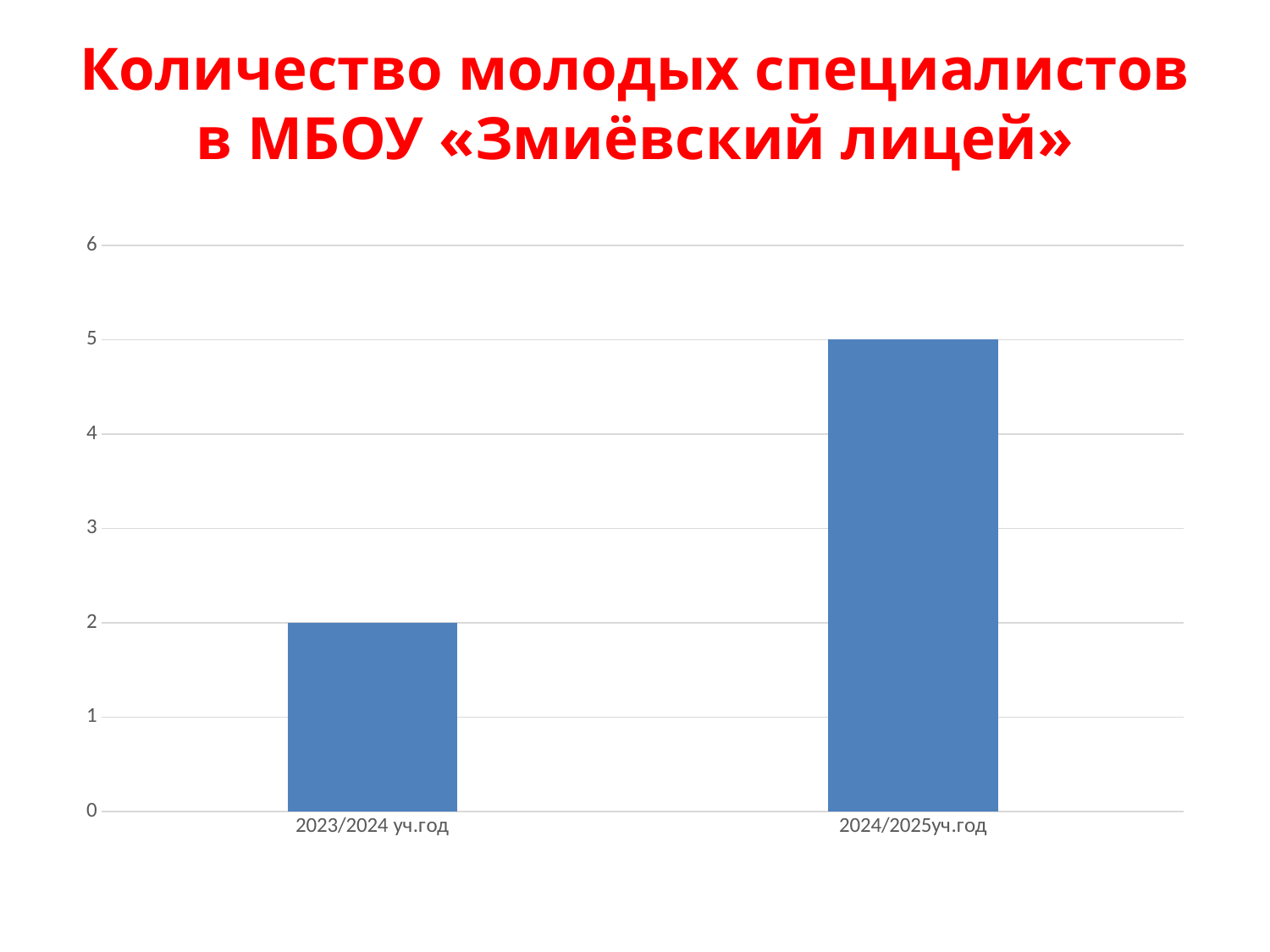
Which is larger: the value for 2023/2024 уч.год or the value for 2024/2025уч.год? 2024/2025уч.год Do the values rise or fall from 2023/2024 уч.год to 2024/2025уч.год? Rise Is the value for 2024/2025уч.год greater or less than 4? greater What type of chart is shown on the slide? Bar chart What is the difference between the values for 2024/2025уч.год and 2023/2024 уч.год? 3 Which category has the highest value? 2024/2025уч.год Which category has the lowest value? 2023/2024 уч.год Is the value for 2023/2024 уч.год greater or less than 3? less How many categories are shown on the x axis? 2 What is the value for 2023/2024 уч.год? 2 What is the value for 2024/2025уч.год? 5 What is the title of the slide? Количество молодых специалистов в МБОУ «Змиёвский лицей»